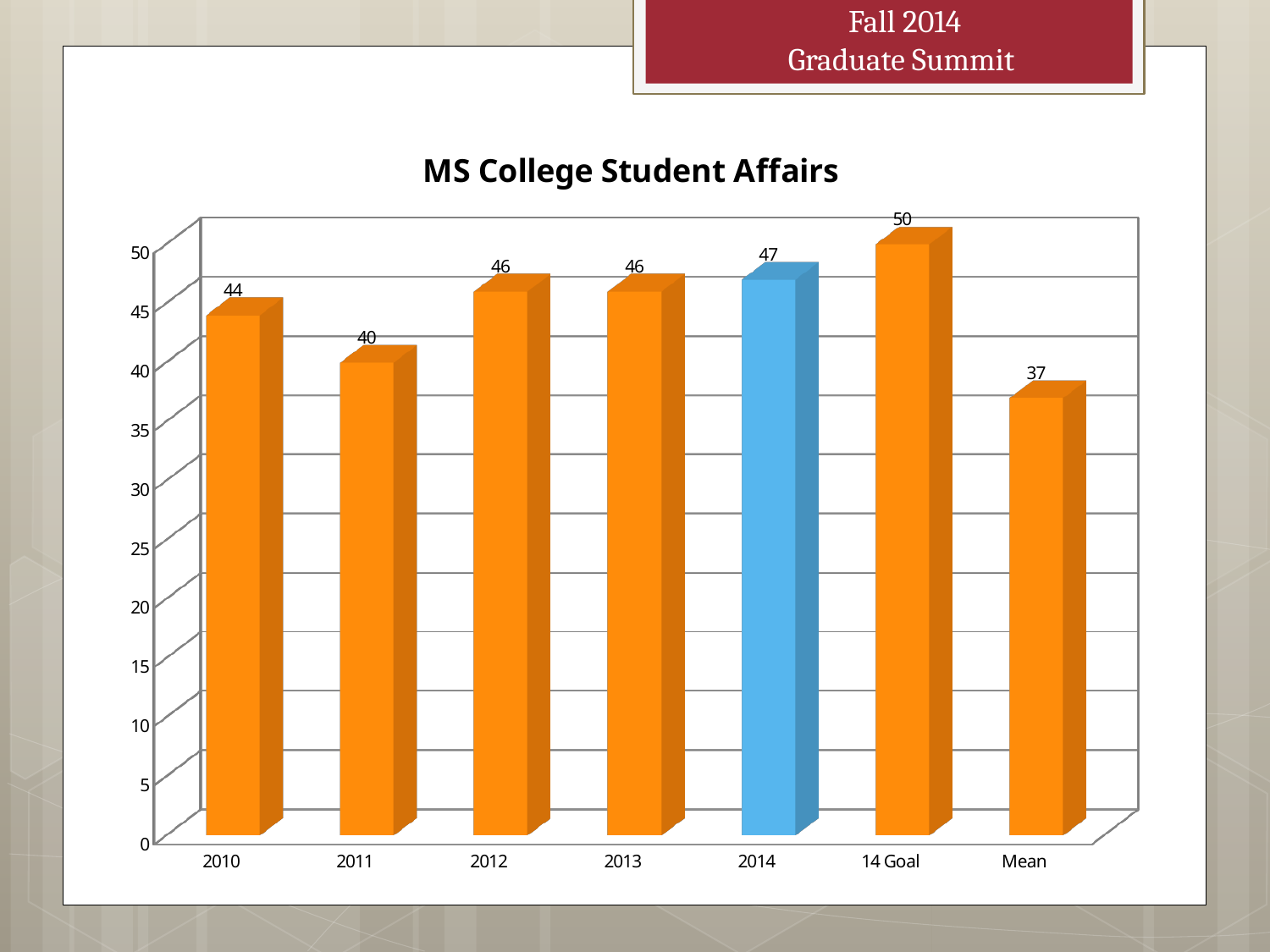
What is the title of the chart? MS College Student Affairs What is the value for 2014? 47 What kind of chart is this? Bar chart Which is larger, the value for 2011 or the value for 2013? 2013 What is the value for Mean? 37 Which category has the highest value? 14 Goal Which bar is coloured blue rather than orange? 2014 Is the value for 2012 greater or less than 45? greater Which category has the lowest value? Mean How many categories are shown on the x axis? 7 What is the value for 2010? 44 What is the difference between the 14 Goal value and the 2014 value? 3